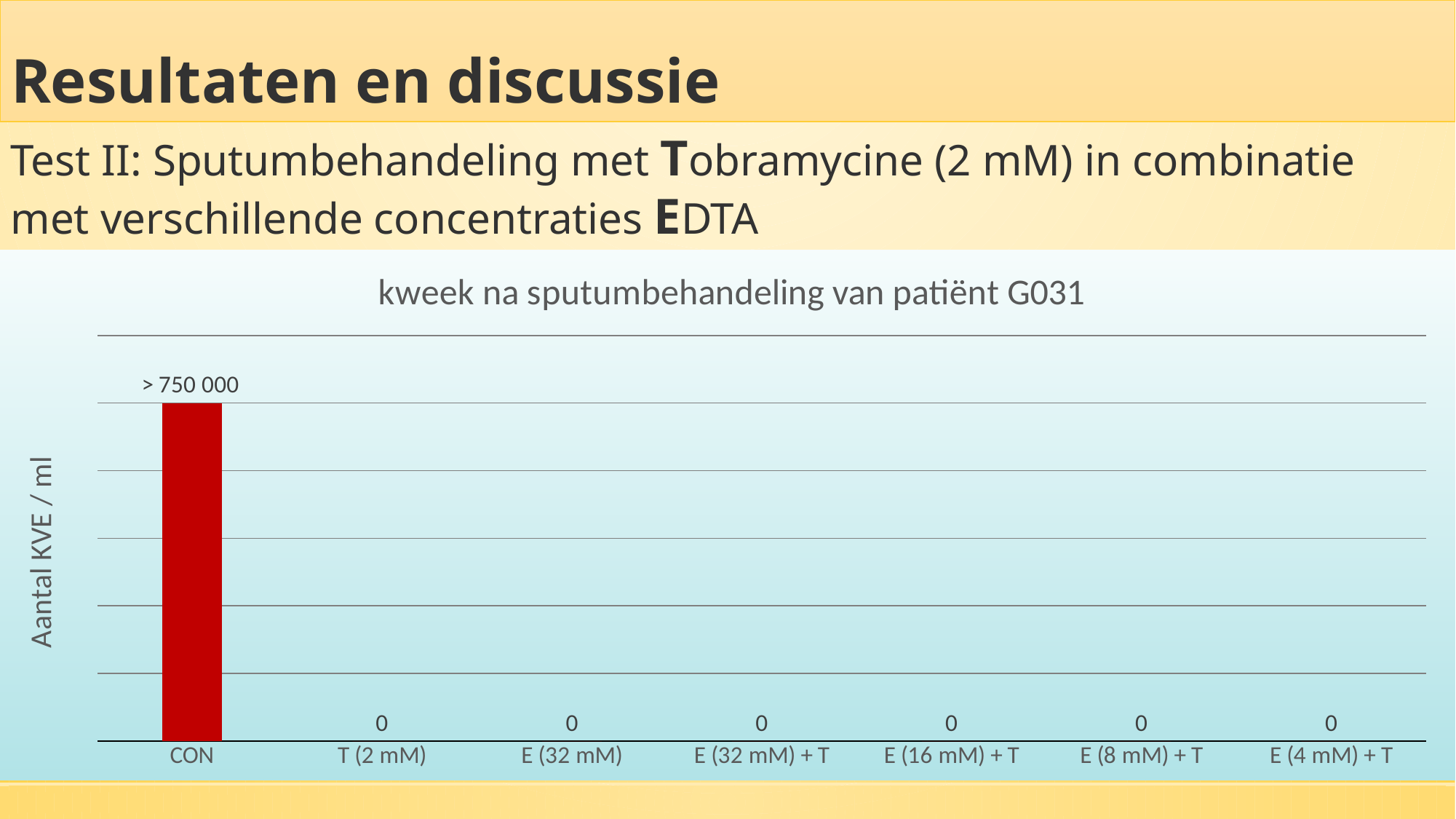
How many categories are shown on the x axis? 7 Which is larger, the value for CON or the value for E (16 mM) + T? CON What value is shown for T (2 mM)? 0 What is the data label shown above the CON bar? > 750 000 What is the label of the y axis? Aantal KVE / ml What value is shown for E (32 mM) + T? 0 What kind of chart is shown on the slide? Bar chart Which category has the highest value? CON What is the title of the chart? kweek na sputumbehandeling van patiënt G031 What value is shown for E (4 mM) + T? 0 How many categories have a value of 0? 6